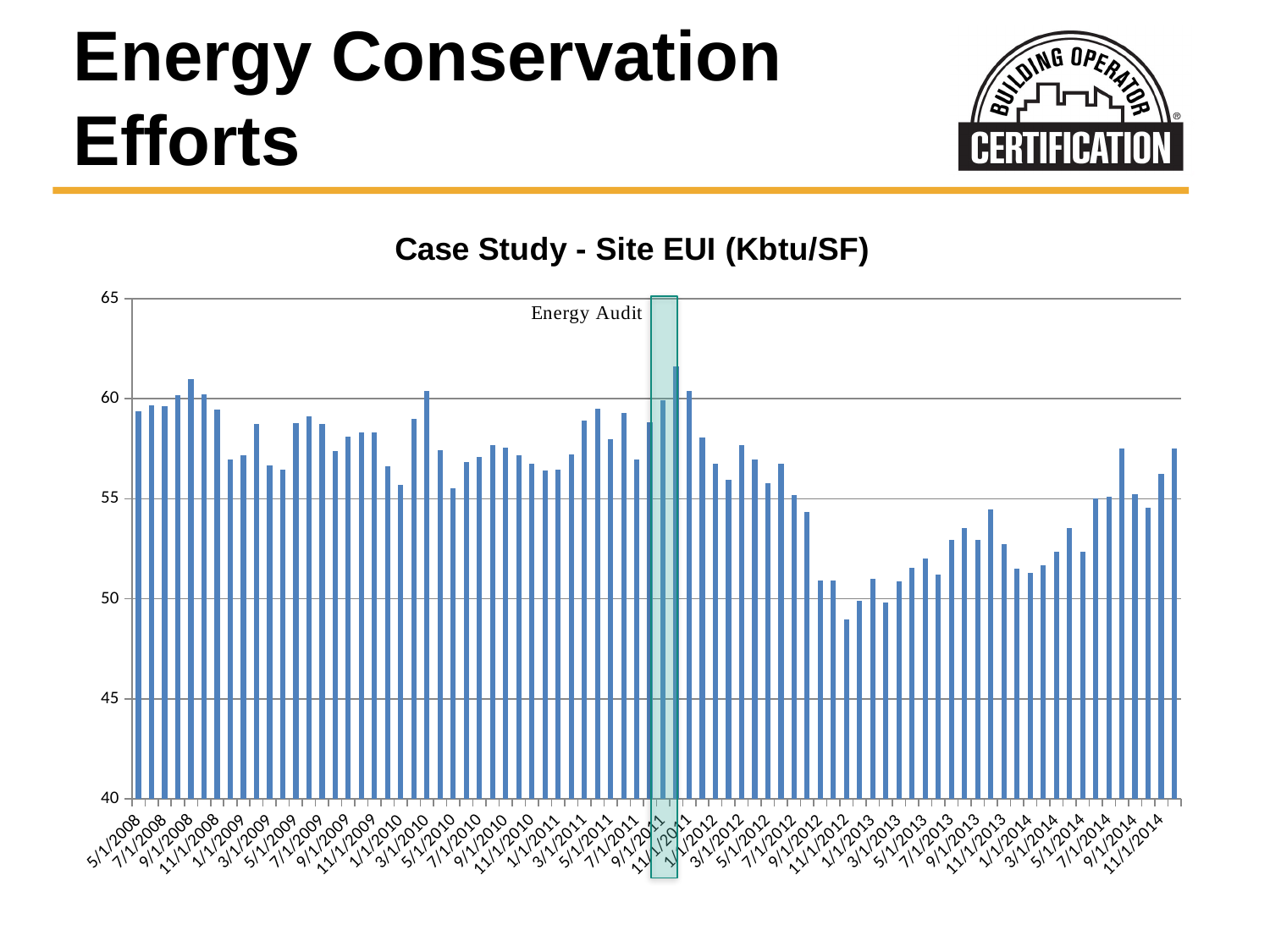
Is the value for 5/1/2008 greater or less than 55? greater Is the value for 9/1/2008 greater or less than 60? greater What event is annotated with a highlighted box on the chart? Energy Audit Which is larger, the value for 5/1/2008 or the value for 11/1/2012? 5/1/2008 Is the value for 11/1/2014 greater or less than 55? greater What kind of chart is shown on the slide? Bar chart What is the title of the chart? Case Study - Site EUI (Kbtu/SF) Which is larger, the value for 1/1/2010 or the value for 9/1/2012? 1/1/2010 Between 1/1/2012 and 11/1/2012, do the values generally rise or fall? fall